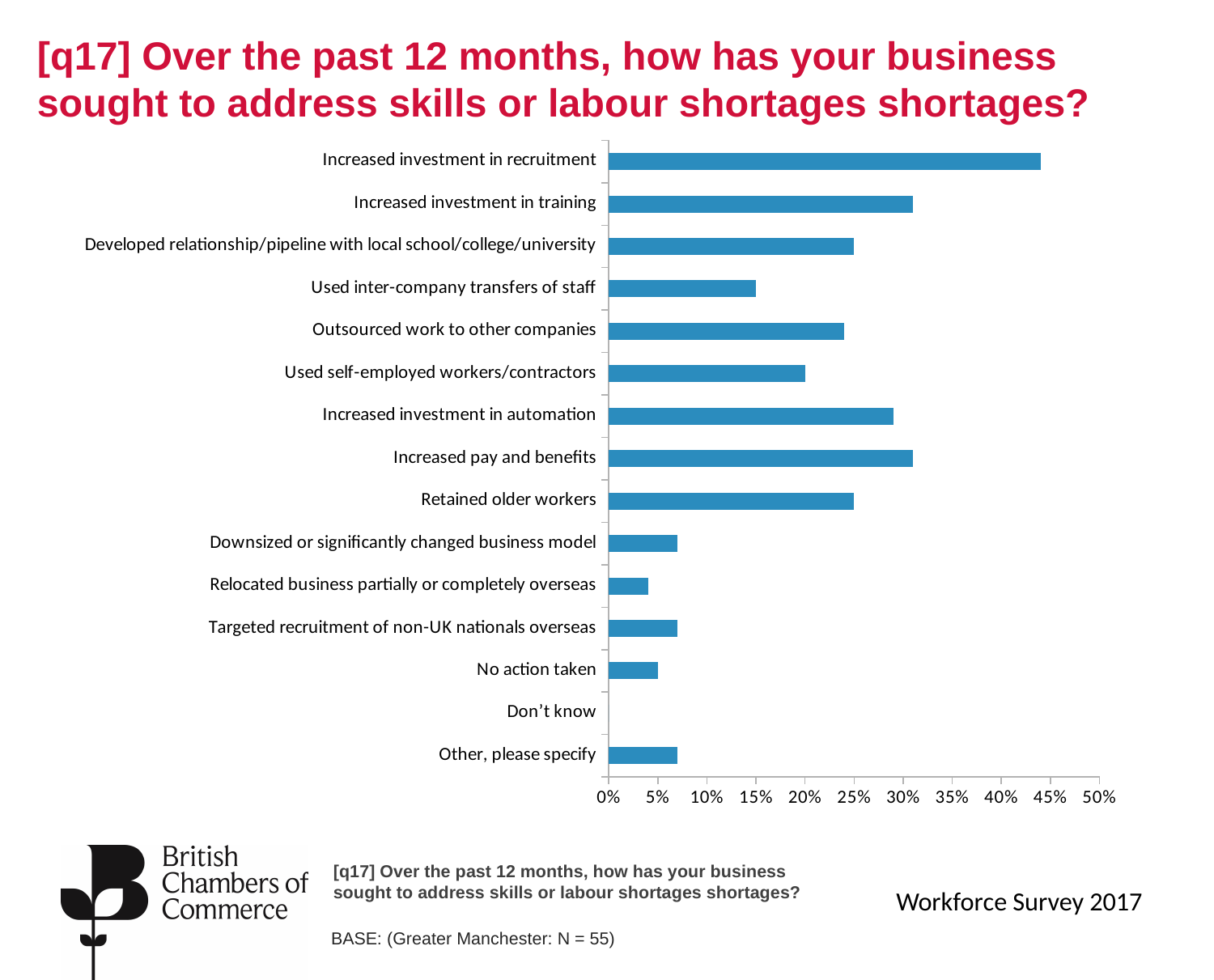
What kind of chart is shown on the slide? bar chart Is the value for Outsourced work to other companies greater or less than 20%? greater How many categories are plotted on the chart? 15 Which category has the lowest value? Don't know What is the maximum value shown on the horizontal axis? 50% Which is larger, the value for Downsized or significantly changed business model or the value for Relocated business partially or completely overseas? Downsized or significantly changed business model Which is larger, the value for Increased investment in recruitment or the value for Increased investment in training? Increased investment in recruitment Is the value for Increased investment in recruitment greater or less than 40%? greater Which category has the highest value? Increased investment in recruitment Is the value for No action taken greater or less than 10%? less